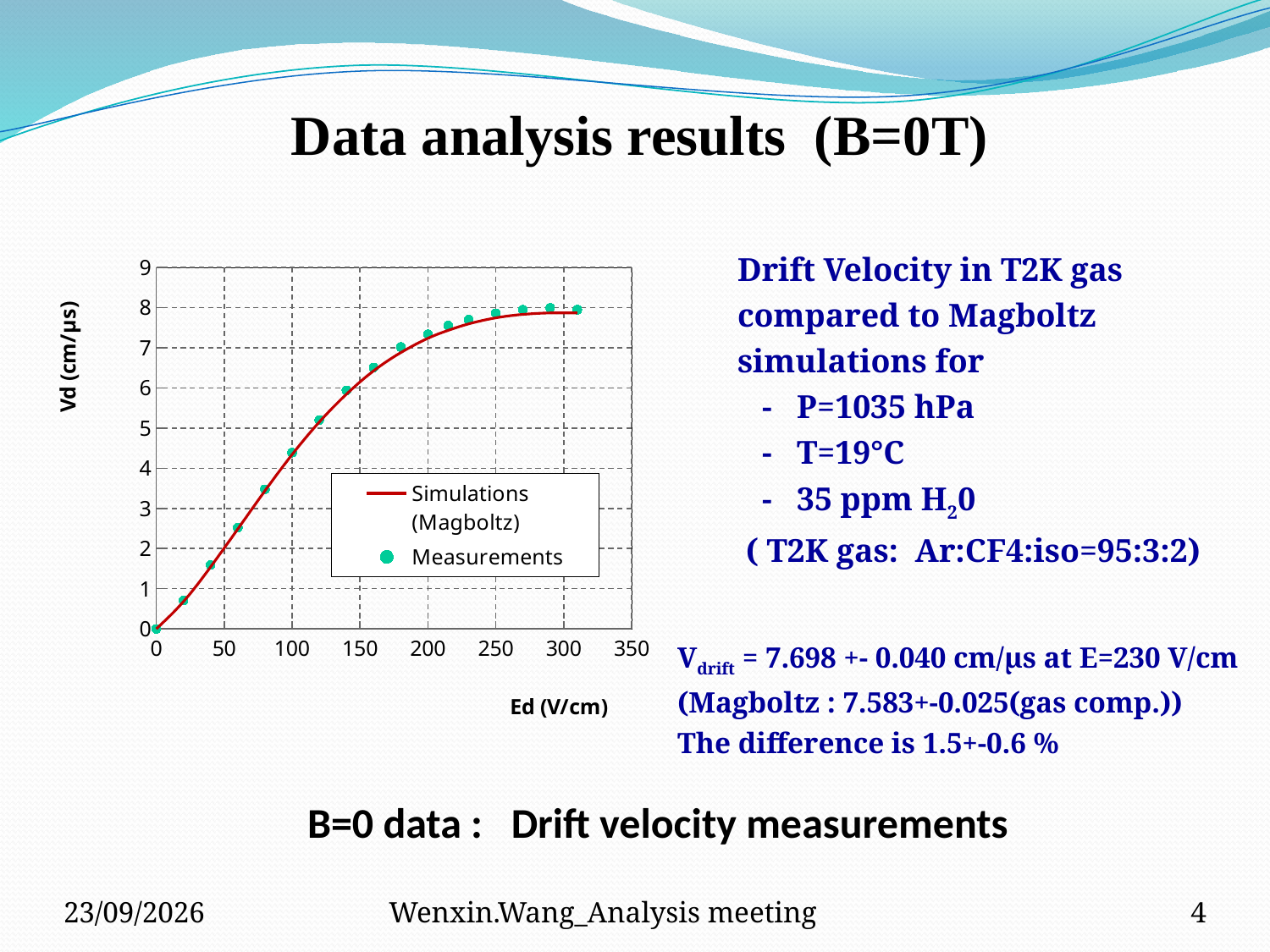
Which is larger, the measured drift velocity at Ed=200 V/cm or at Ed=100 V/cm? Ed=200 V/cm How many series does the chart legend list? 2 Is the measured drift velocity at Ed=300 V/cm greater or less than 7 cm/μs? greater What is the label of the x axis of the chart? Ed (V/cm) Is the measured drift velocity at Ed=20 V/cm greater or less than 1 cm/μs? less Is the measured drift velocity at Ed=100 V/cm greater or less than 4 cm/μs? greater What are the two series named in the chart legend? Simulations (Magboltz) and Measurements At which end of the x axis is the drift velocity lowest, Ed=0 or Ed=300 V/cm? Ed=0 Does the drift velocity rise or fall as Ed increases along the x axis? rises What is the highest value shown on the y axis of the chart? 9 What kind of chart is shown on the slide? line chart with measurement points (scatter)